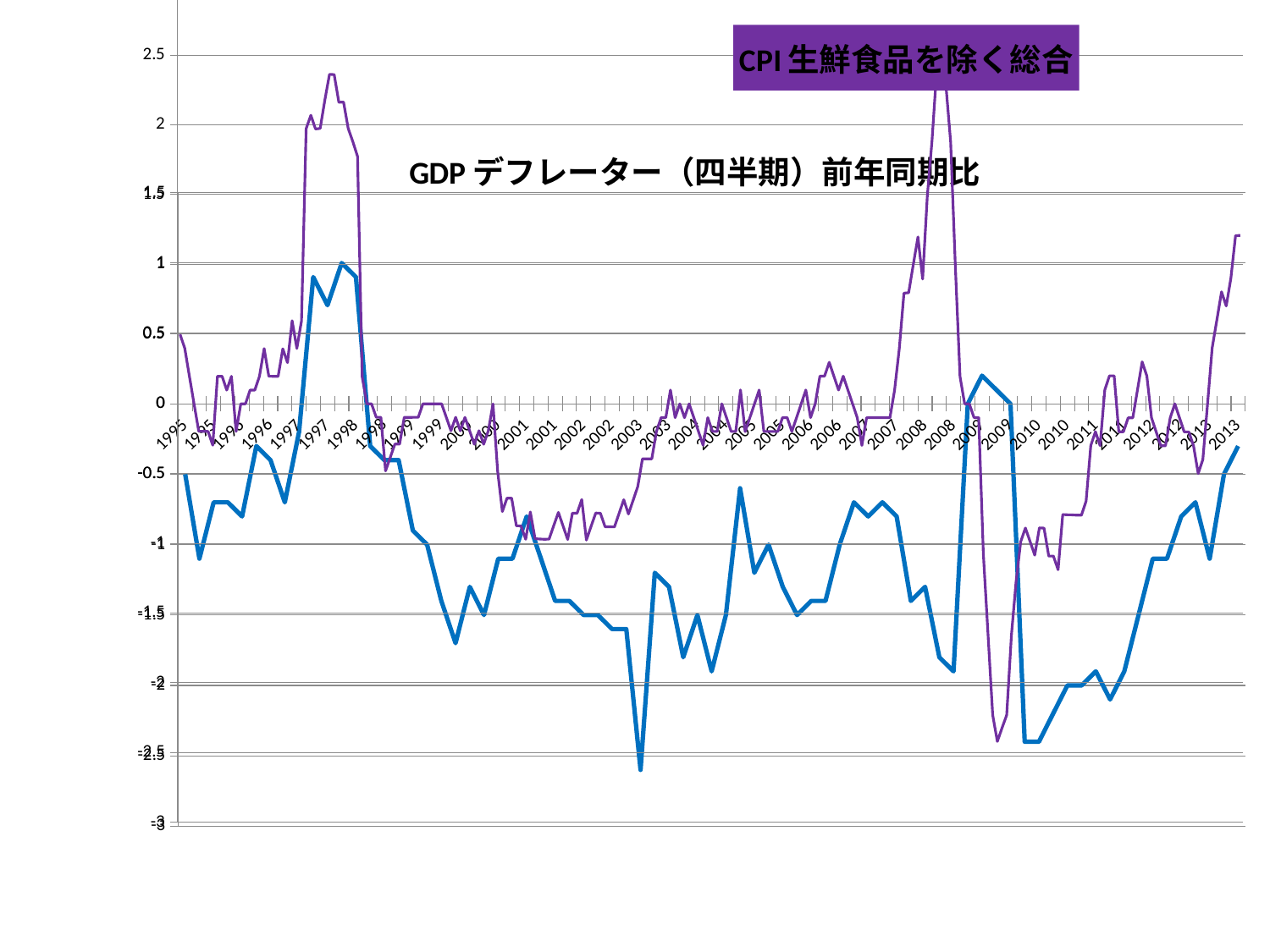
What colour is the line for GDP デフレーター（四半期）前年同期比? blue Which series has the higher value at the end of 2013, CPI 生鮮食品を除く総合 or GDP デフレーター? CPI 生鮮食品を除く総合 Is the value of the CPI 生鮮食品を除く総合 line at the end of 2013 greater or less than 1? greater Is the lowest value of the CPI 生鮮食品を除く総合 line, reached around 2009, greater or less than -2? less Is the peak of the CPI 生鮮食品を除く総合 line around 1997 greater or less than 2? greater What colour is the line for CPI 生鮮食品を除く総合? purple Does the CPI 生鮮食品を除く総合 line rise or fall from its 2008 peak to 2009? fall What kind of chart is shown on the slide? line chart How many data series are plotted on the chart? 2